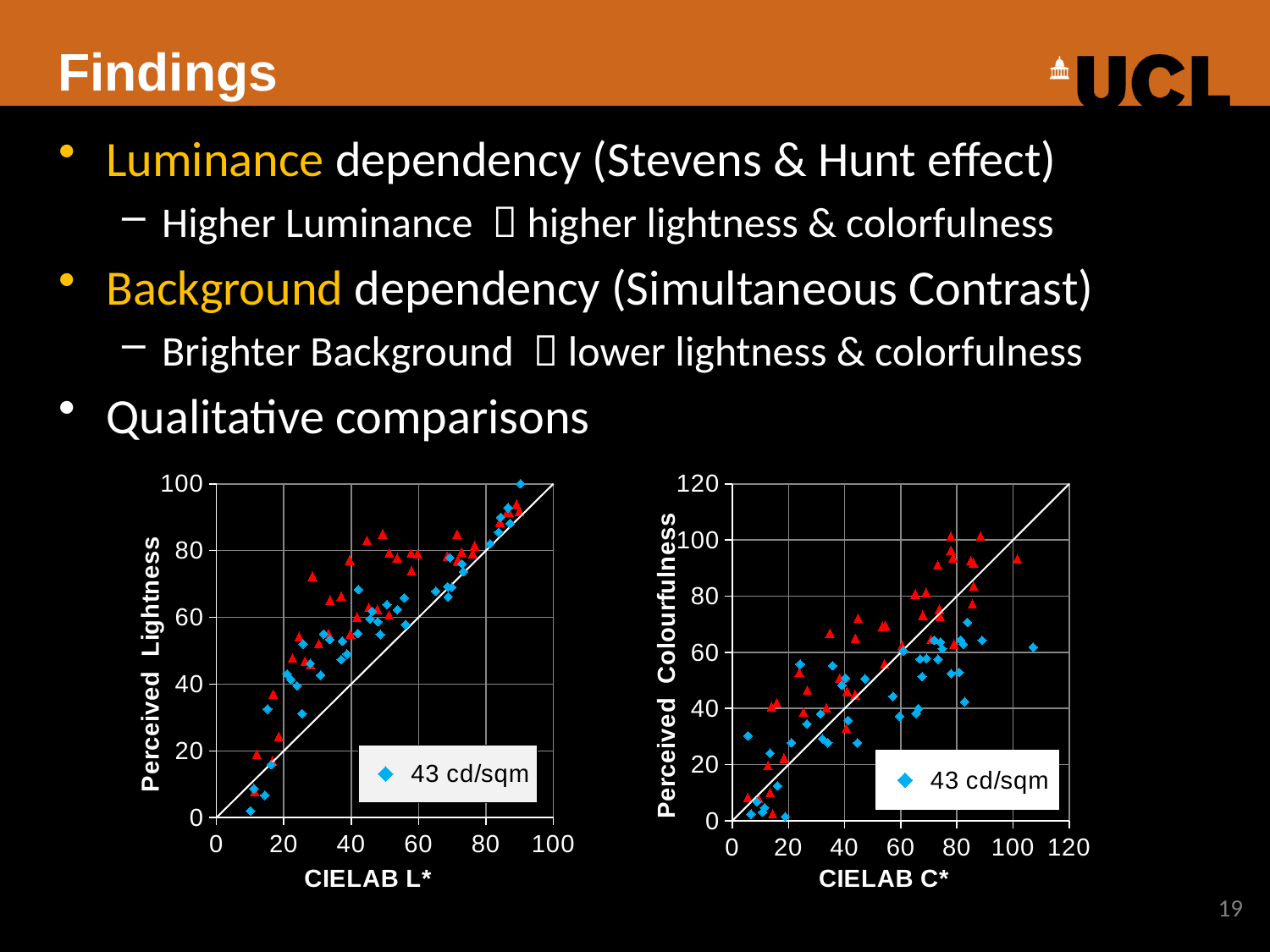
In the right chart, what is the highest value shown on the y axis? 120 How many series does the legend of the right chart list? 1 In the right chart, what is the label of the x axis? CIELAB C* What kind of chart is the left chart, with CIELAB L* on the x axis? Scatter chart In the left chart, what is the highest value shown on the x axis? 100 In the left chart, do the perceived lightness values generally rise or fall as CIELAB L* increases? Rise In the right chart, do the perceived colourfulness values generally rise or fall as CIELAB C* increases? Rise What kind of chart is the right chart, with CIELAB C* on the x axis? Scatter chart How many series does the legend of the left chart list? 1